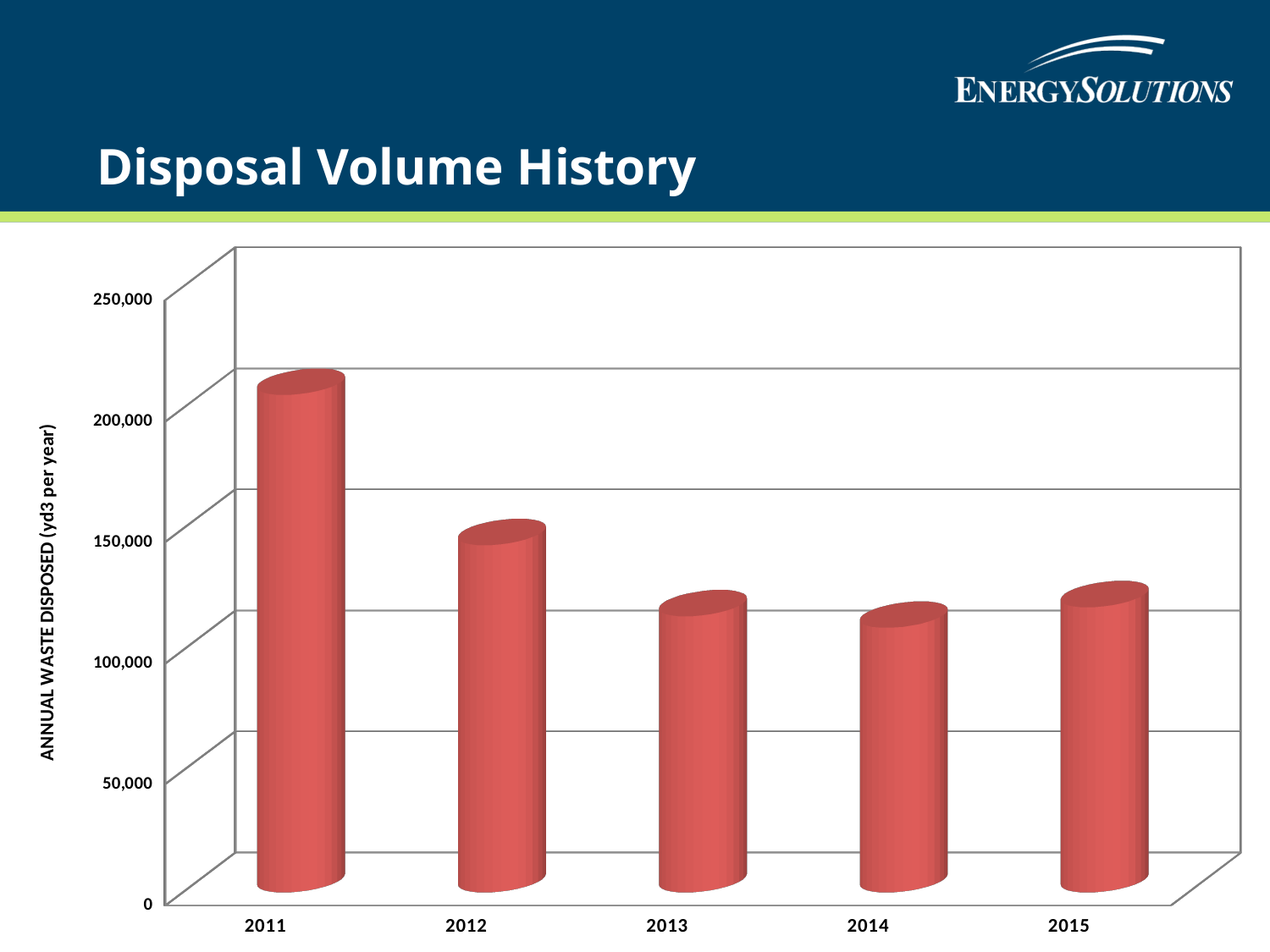
How many years are shown on the x axis of the chart? 5 Is the value for 2015 greater or less than 150,000? less Which year has the highest annual waste disposed? 2011 Which year has the larger annual waste disposed, 2011 or 2012? 2011 Is the value for 2011 greater or less than 150,000? greater What is the title of the vertical axis of the chart? ANNUAL WASTE DISPOSED (yd3 per year) Is the value for 2014 greater or less than 100,000? greater Do the values rise or fall from 2011 to 2014? fall What kind of chart is shown on the slide? bar chart Which year has the lowest annual waste disposed? 2014